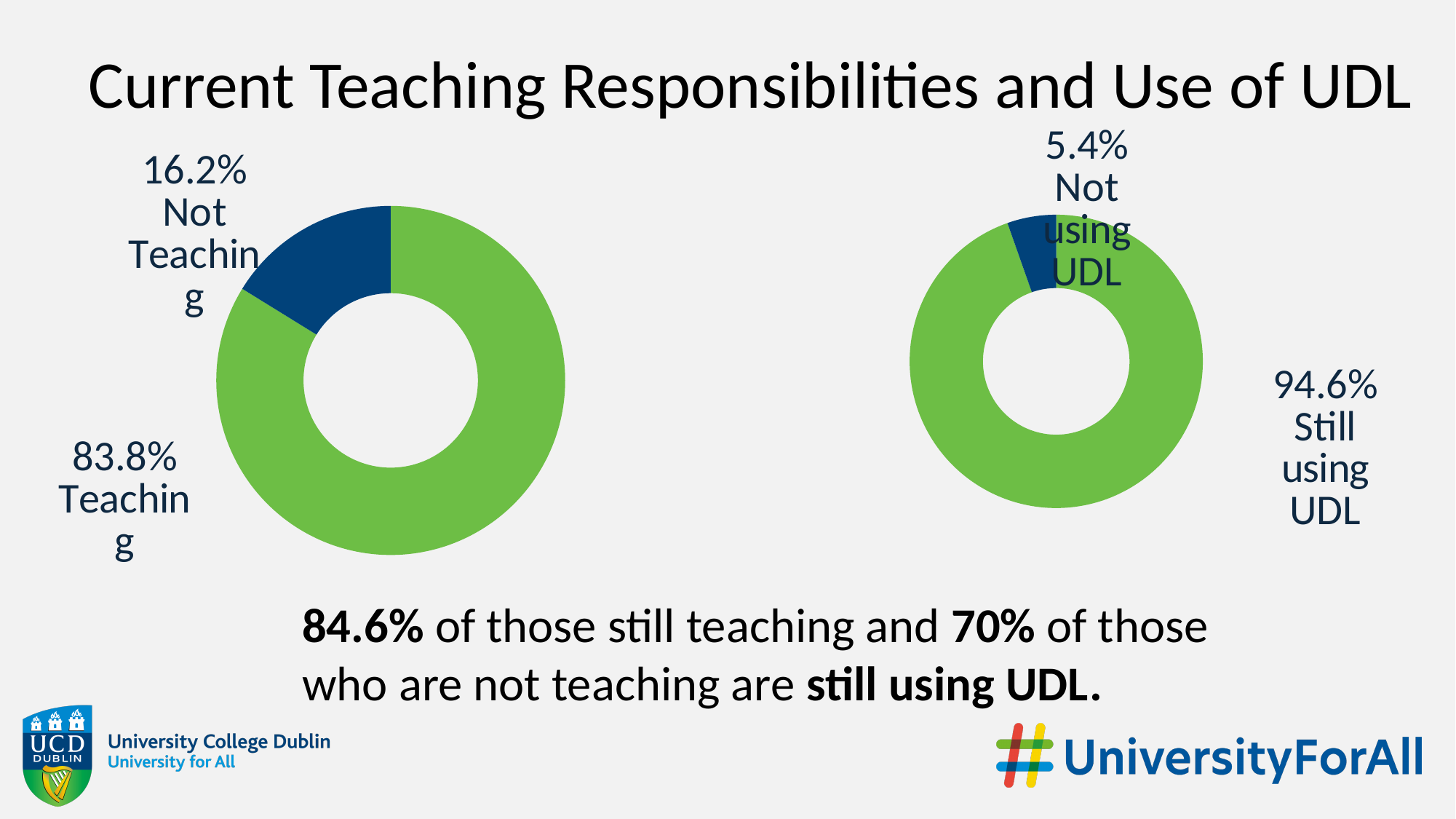
In the left chart, which category has the largest share? Teaching Which is larger: the Not Teaching share in the left chart or the Not using UDL share in the right chart? Not Teaching In the right chart, what percentage is labelled Not using UDL? 5.4% In the right chart, what is the difference between the Still using UDL and Not using UDL percentages? 89.2% In the left chart, what is the difference between the Teaching and Not Teaching percentages? 67.6% In the right chart, which category has the smallest share? Not using UDL What is the title of the slide containing the two charts? Current Teaching Responsibilities and Use of UDL In the left chart, what percentage is labelled Not Teaching? 16.2% In the left chart, what percentage is labelled Teaching? 83.8% What kind of chart is used on the left of the slide? Doughnut chart How many categories does the right chart show? 2 In the right chart, what percentage is labelled Still using UDL? 94.6%